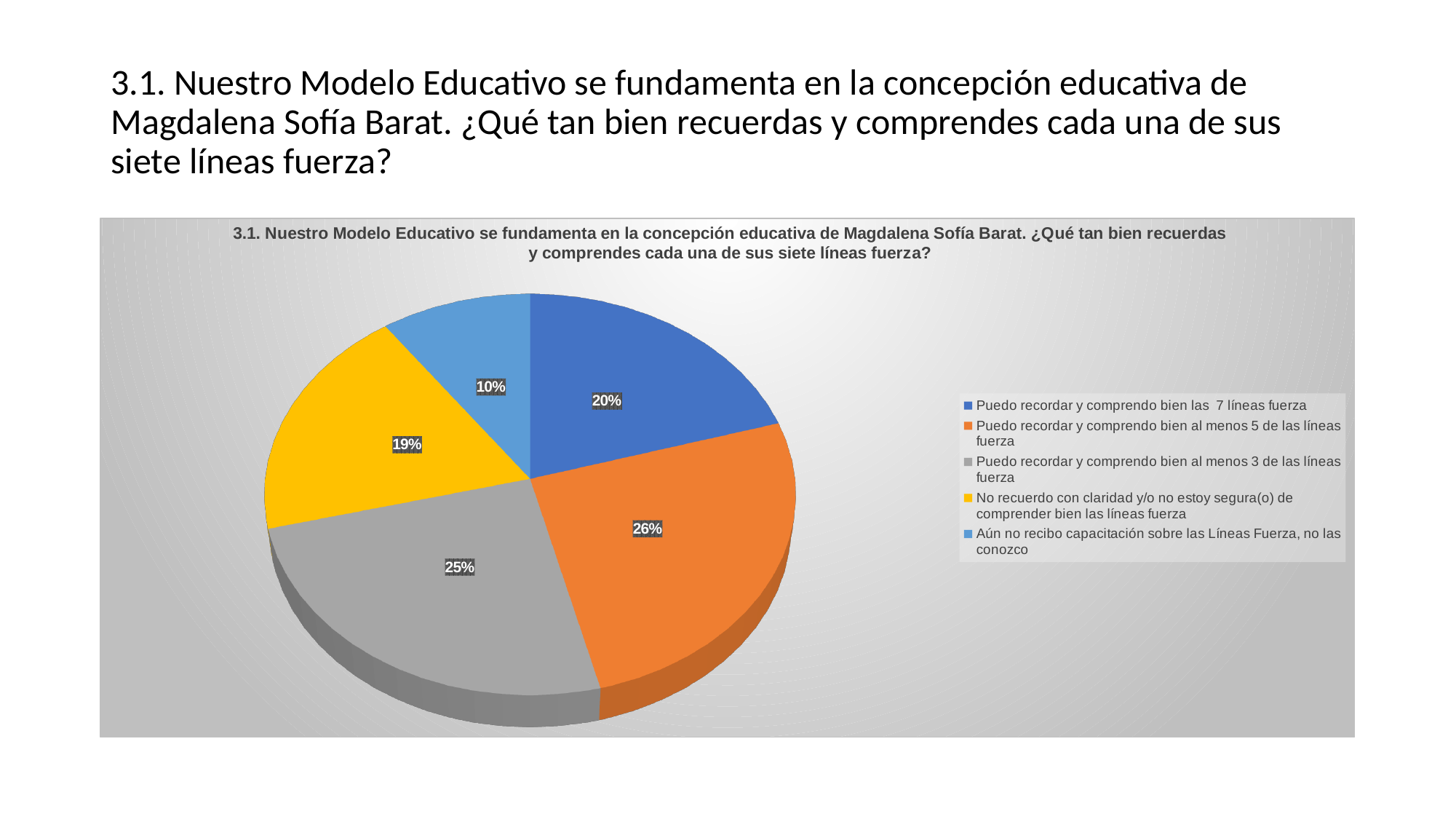
What percentage of respondents said "Aún no recibo capacitación sobre las Líneas Fuerza, no las conozco"? 10% What percentage of respondents said "Puedo recordar y comprendo bien al menos 3 de las líneas fuerza"? 25% What is the difference in percentage points between the "al menos 5" slice and the "Aún no recibo capacitación" slice? 16 What percentage of respondents said "Puedo recordar y comprendo bien al menos 5 de las líneas fuerza"? 26% What percentage of respondents said "No recuerdo con claridad y/o no estoy segura(o) de comprender bien las líneas fuerza"? 19% Which is larger: the share for "Puedo recordar y comprendo bien las 7 líneas fuerza" or the share for "No recuerdo con claridad y/o no estoy segura(o) de comprender bien las líneas fuerza"? Puedo recordar y comprendo bien las 7 líneas fuerza What colour is the slice for "No recuerdo con claridad y/o no estoy segura(o) de comprender bien las líneas fuerza"? yellow What percentage of respondents said "Puedo recordar y comprendo bien las 7 líneas fuerza"? 20% Which response has the largest share of the pie? Puedo recordar y comprendo bien al menos 5 de las líneas fuerza Which response has the smallest share of the pie? Aún no recibo capacitación sobre las Líneas Fuerza, no las conozco How many slices does the pie chart have? 5 What kind of chart is shown on the slide? pie chart